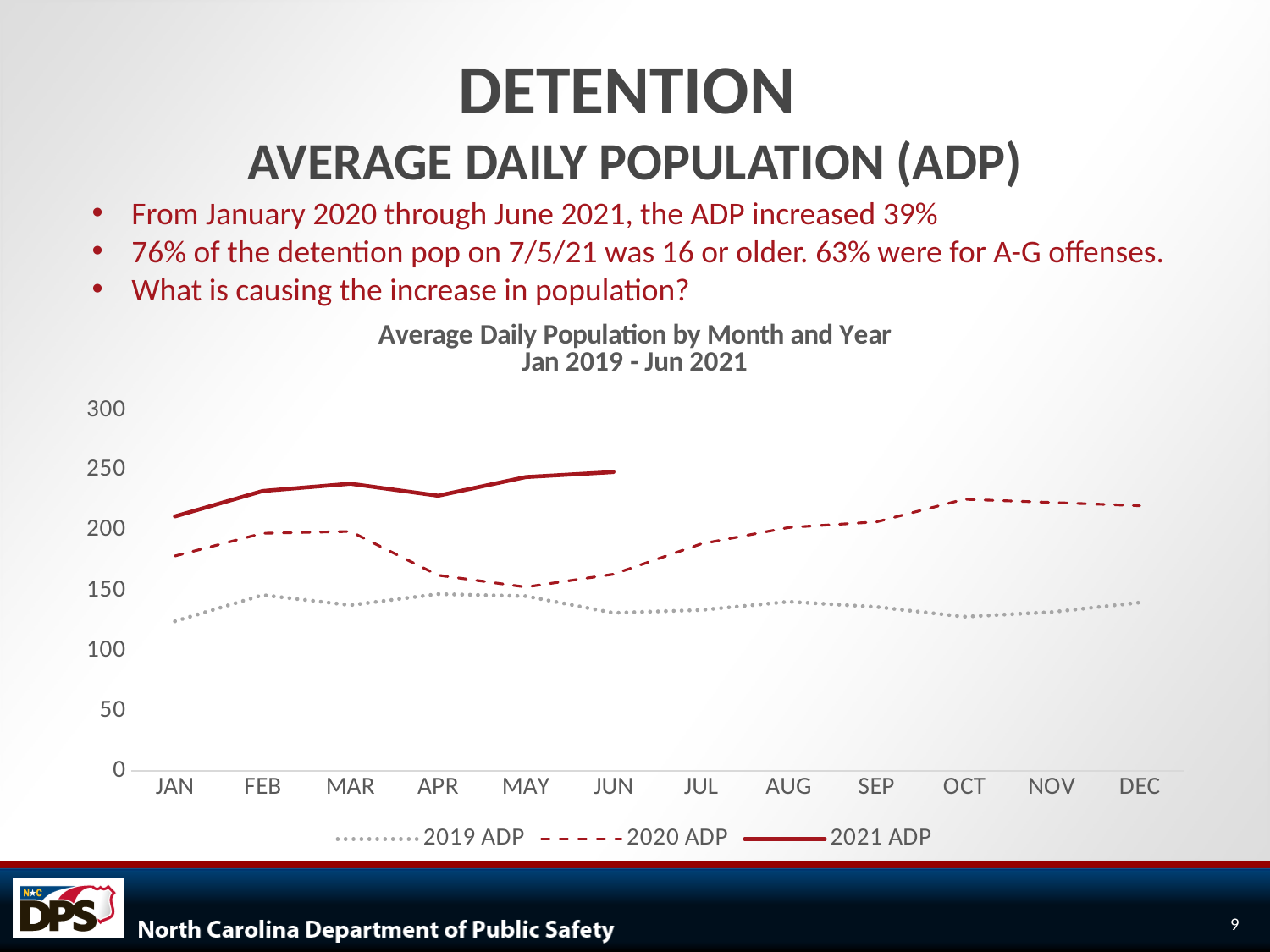
Which series is drawn as a solid line? 2021 ADP How many series does the legend list? 3 What kind of chart is shown on the slide? line chart How many months are shown along the x axis? 12 Does the 2020 ADP rise or fall from JUN to OCT? rise Which is larger in JAN, the 2021 ADP or the 2020 ADP? 2021 ADP Which series has the highest value in JAN? 2021 ADP Is the value for 2020 ADP in MAY greater or less than 200? less Is the value for 2021 ADP in JAN greater or less than 200? greater Is the value for 2019 ADP in JAN greater or less than 150? less What is the title of the chart? Average Daily Population by Month and Year Jan 2019 - Jun 2021